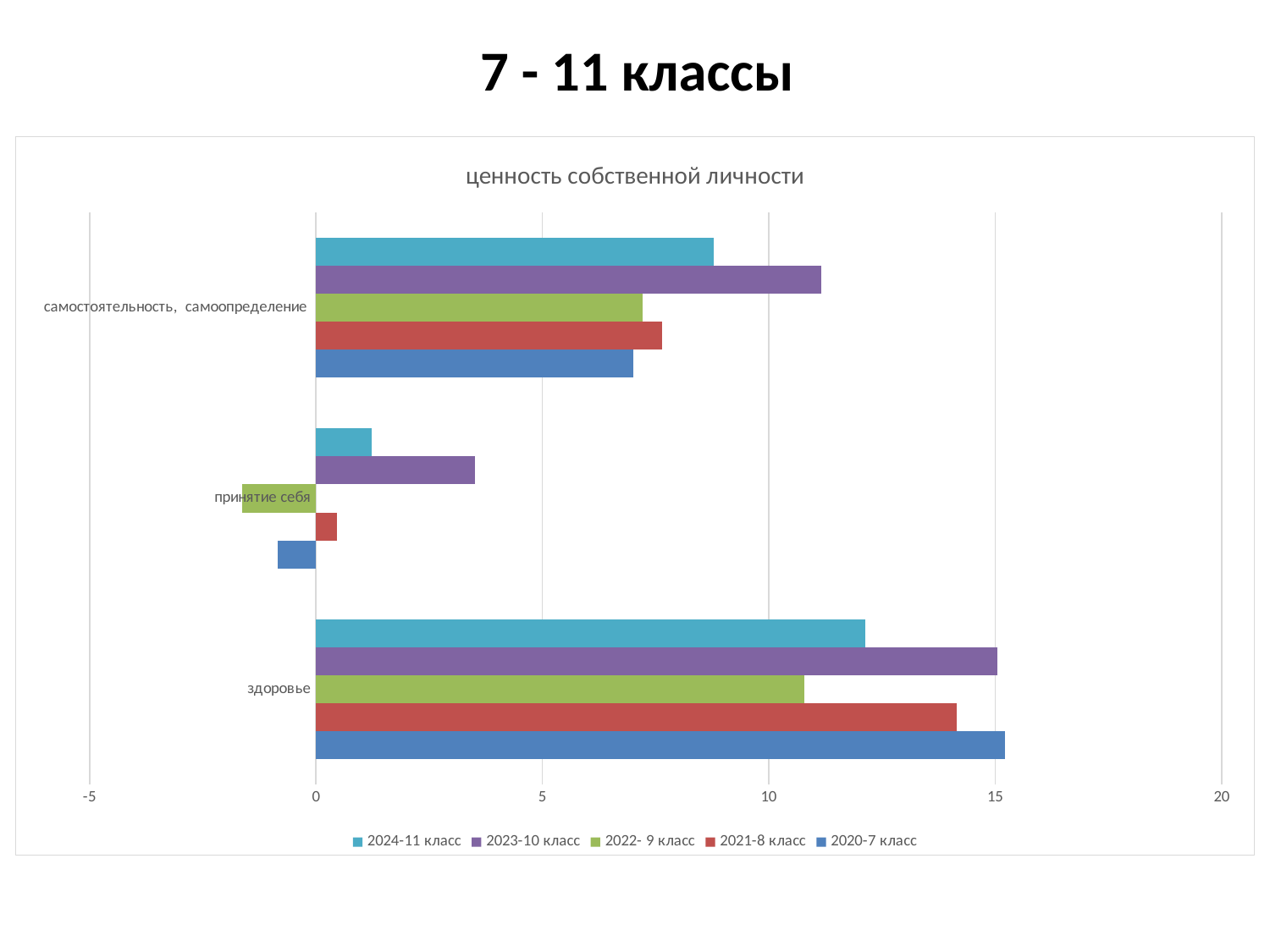
Which series has the highest value for самостоятельность, самоопределение? 2023-10 класс Which series is shown in red in the legend? 2021-8 класс Is the value for 2024-11 класс in самостоятельность, самоопределение greater or less than 10? less Is the value for 2023-10 класс in здоровье greater or less than 10? greater Which series has the lowest value for принятие себя? 2022- 9 класс Which series has the highest value for принятие себя? 2023-10 класс Is the value for 2022- 9 класс in принятие себя greater or less than 0? less How many categories are shown on the vertical axis? 3 What kind of chart is shown on the slide? bar chart How many series does the legend list? 5 For здоровье, which is larger: the value for 2024-11 класс or for 2022- 9 класс? 2024-11 класс What is the title of the chart? ценность собственной личности